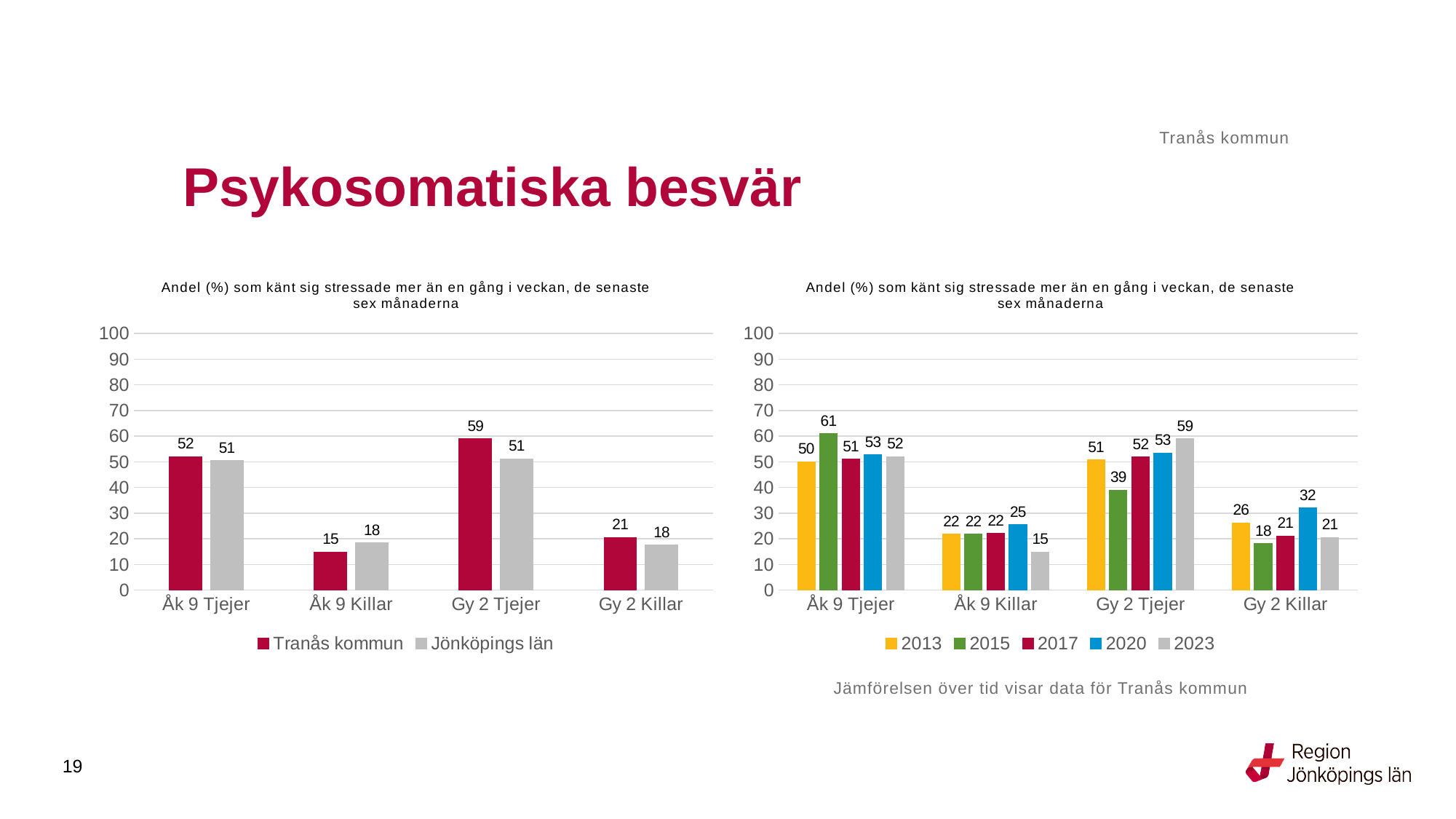
In the left chart, what is the value for Jönköpings län for Åk 9 Killar? 18 In the left chart, which category has the lowest value for Tranås kommun? Åk 9 Killar In the right chart, is the value for 2015 for Gy 2 Tjejer larger or smaller than the value for 2013 for Gy 2 Tjejer? smaller In the left chart, what is the difference between Tranås kommun and Jönköpings län for Gy 2 Tjejer? 8 In the right chart, which year has the highest value for Gy 2 Killar? 2020 In the right chart, how many series does the legend list? 5 In the right chart, what is the value for 2023 for Gy 2 Tjejer? 59 What kind of chart is the right chart? Bar chart In the right chart, which year has the lowest value for Åk 9 Killar? 2023 In the left chart, how many series does the legend list? 2 In the left chart, what is the value for Tranås kommun for Gy 2 Tjejer? 59 In the right chart, what is the value for 2015 for Åk 9 Tjejer? 61